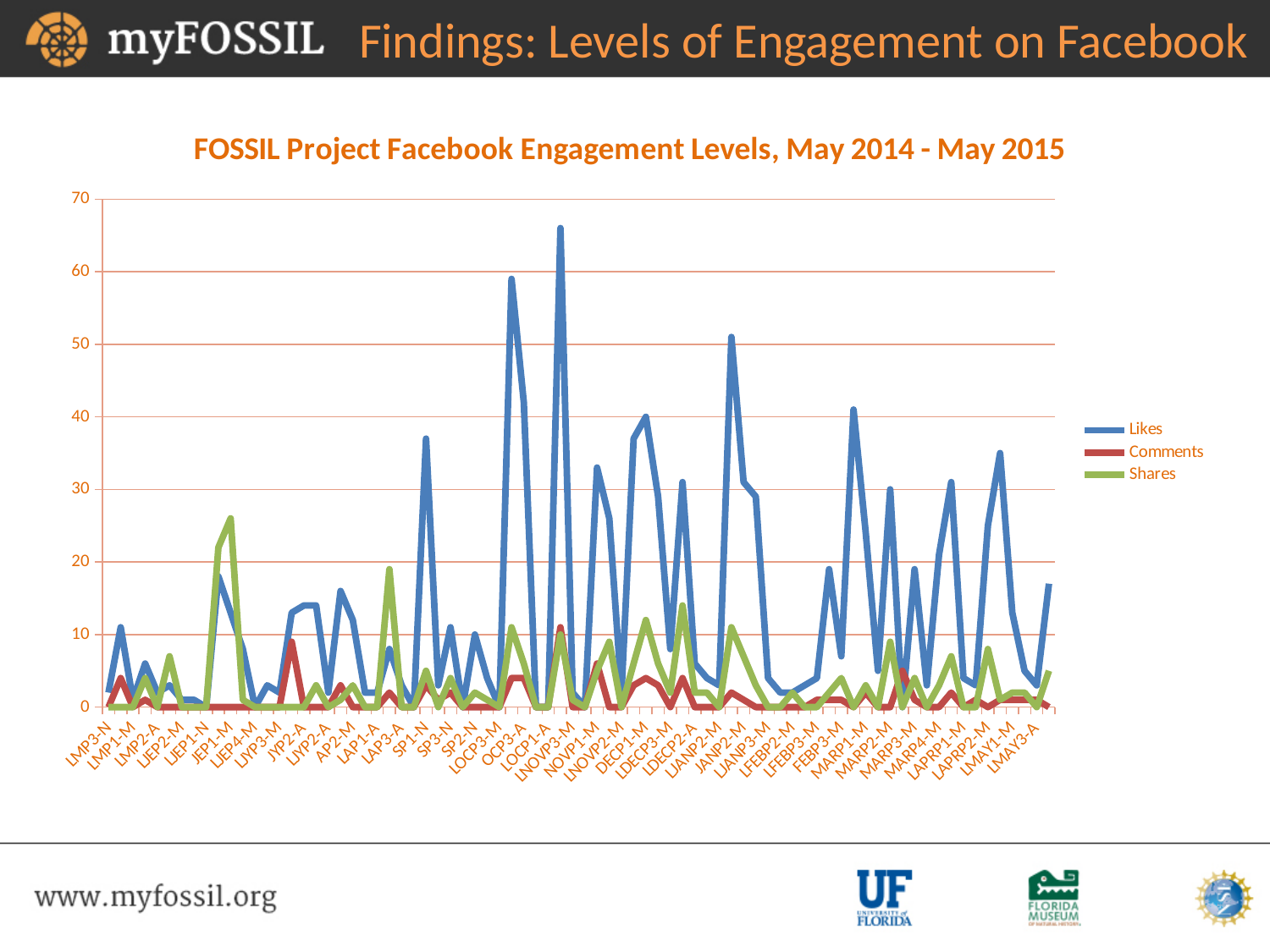
Is the highest value of the Shares series greater or less than 20? greater Is the highest value of the Likes series greater or less than 70? less How many series does the legend list? 3 Which series reaches the highest peak on the chart? Likes Which series has the lowest peak value on the chart? Comments What is the title of the chart? FOSSIL Project Facebook Engagement Levels, May 2014 - May 2015 Which series is drawn in blue? Likes What kind of chart is shown on the slide? Line chart Is the highest value of the Comments series greater or less than 20? less What is the maximum value shown on the vertical axis? 70 Which series has the higher peak, Shares or Comments? Shares